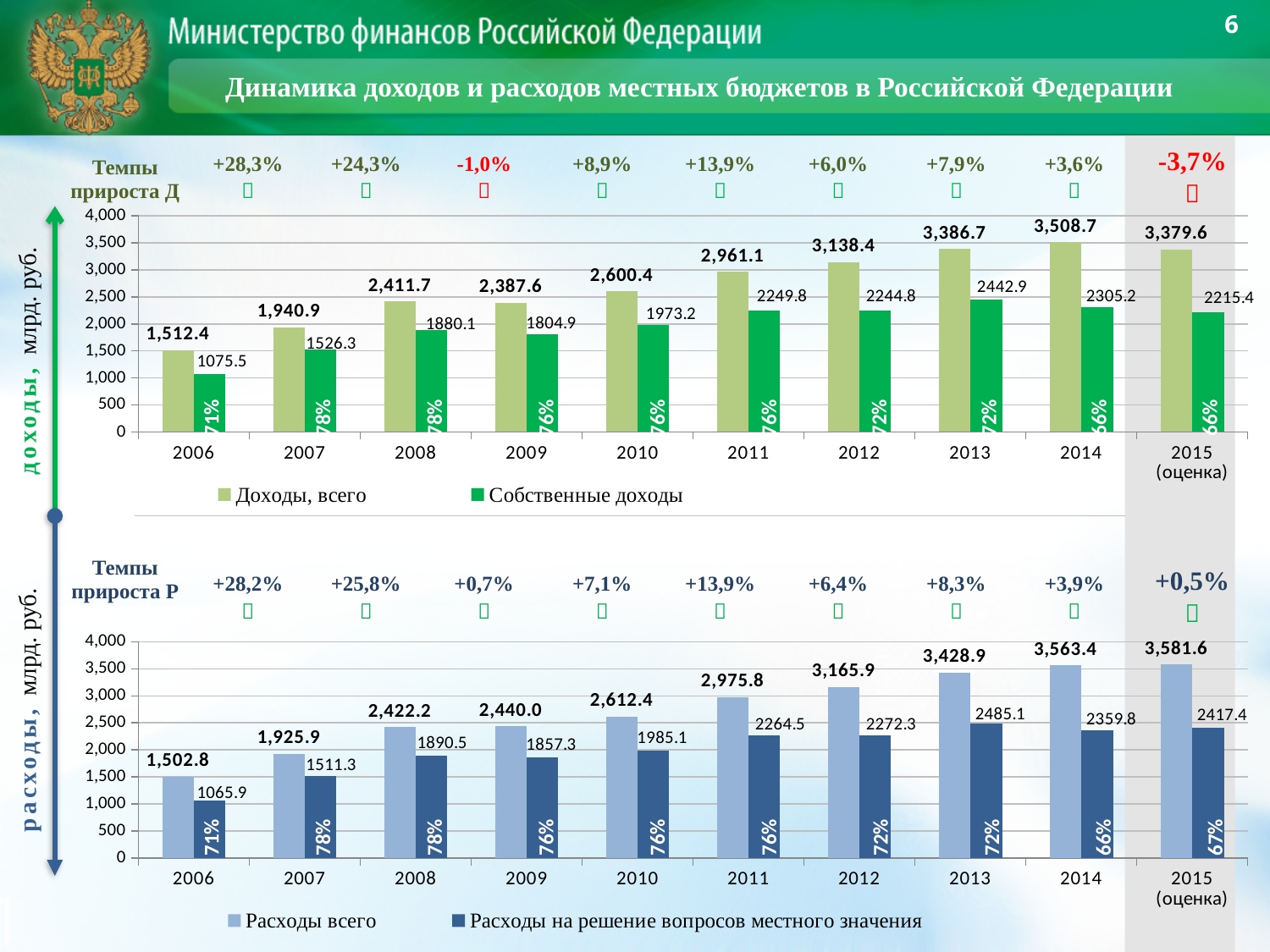
In the top chart (Доходы), what is the value of Доходы, всего for 2014? 3,508.7 In the bottom chart (Расходы), which is larger: Расходы всего in 2009 or in 2008? 2009 In the top chart (Доходы), what is the value of Собственные доходы for 2011? 2249.8 What type of chart is the top chart (Доходы)? Bar chart In the bottom chart (Расходы), what is the value of Расходы на решение вопросов местного значения for 2008? 1890.5 How many years (categories) are shown on the x axis of the top chart (Доходы)? 10 In the top chart (Доходы), which year has the highest value of Доходы, всего? 2014 In the bottom chart (Расходы), what is the value of Расходы всего for 2015 (оценка)? 3,581.6 In the top chart (Доходы), what is the difference between Доходы, всего and Собственные доходы in 2006? 436.9 In the bottom chart (Расходы), does Расходы всего rise or fall from 2006 to 2015? Rise How many series does the legend of the bottom chart (Расходы) list? 2 In the bottom chart (Расходы), which year has the lowest value of Расходы всего? 2006